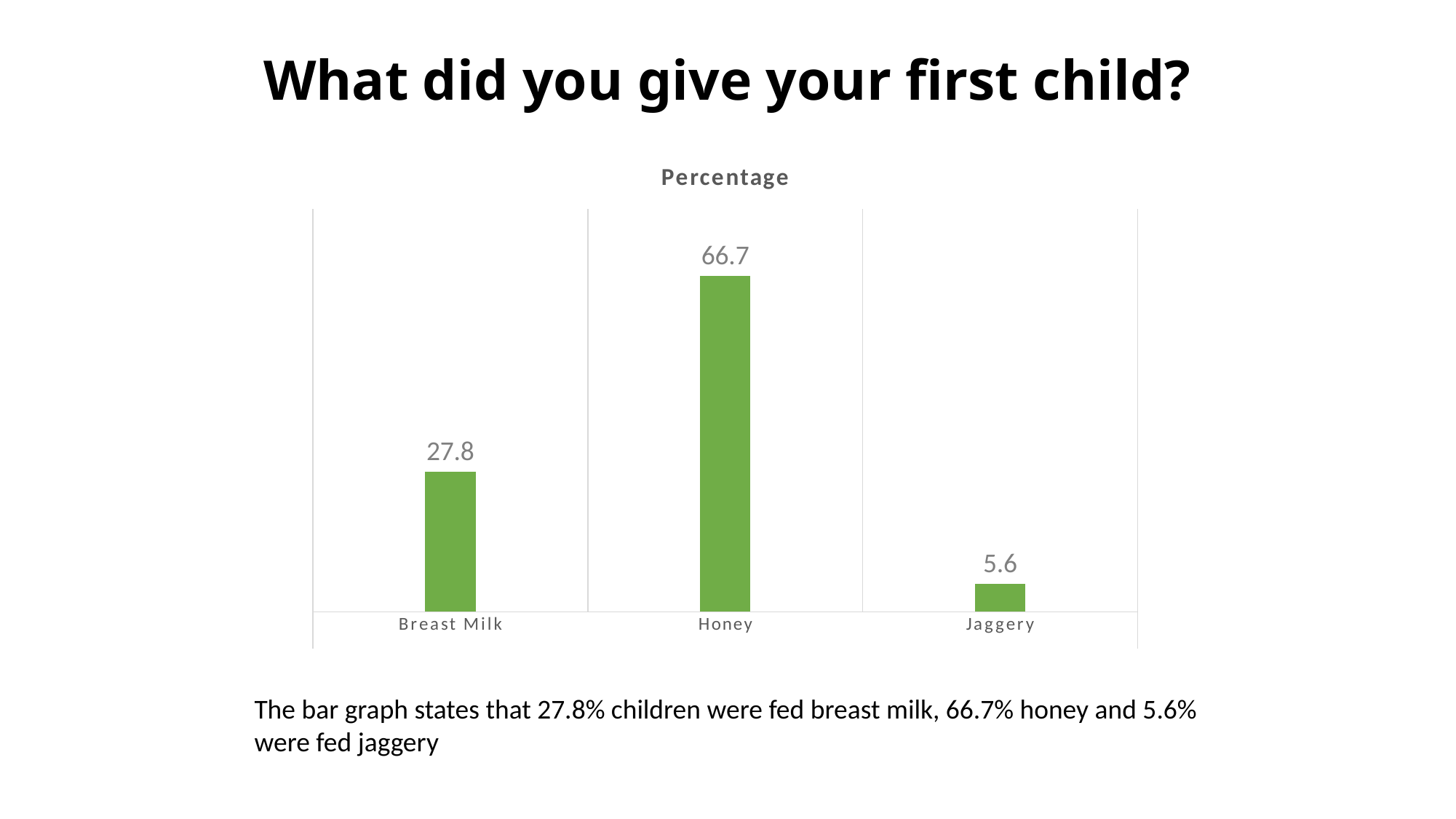
What is the difference between the values for Breast Milk and Jaggery? 22.2 What is the title of the chart? Percentage How many categories are shown on the x axis? 3 What is the value for Honey? 66.7 What colour are the bars in the chart? Green Which is larger, the value for Breast Milk or the value for Jaggery? Breast Milk What kind of chart is shown on the slide? Bar chart What is the difference between the values for Honey and Breast Milk? 38.9 What is the value for Jaggery? 5.6 Which category has the highest value? Honey What is the value for Breast Milk? 27.8 Which category has the lowest value? Jaggery